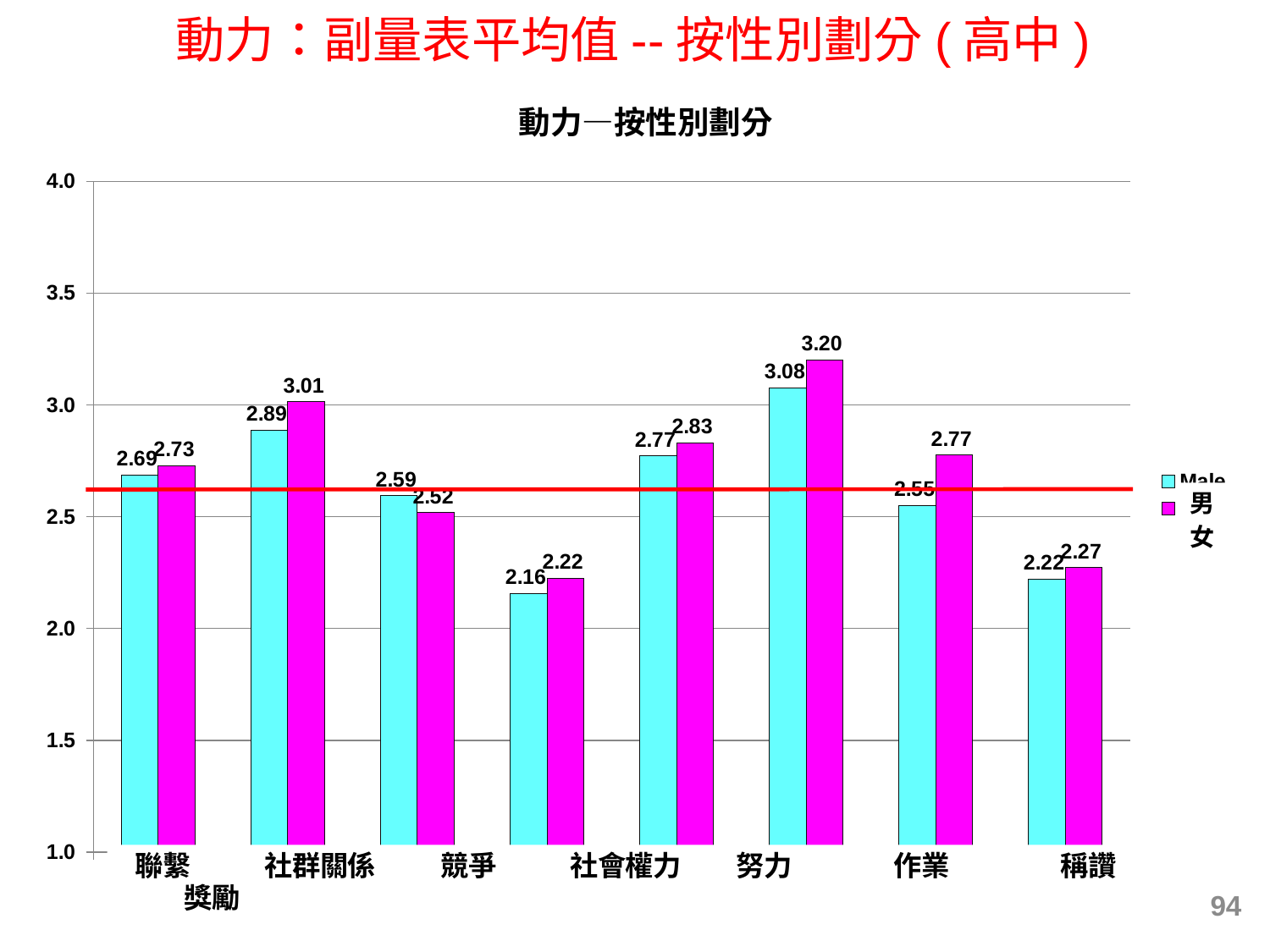
What is the value for 男 (male) in the 競爭 category? 2.59 In the 競爭 category, which is larger, the 男 (male) value or the 女 (female) value? 男 (male) What colour are the bars for the 女 (female) series? magenta How many categories are shown on the x axis of the chart? 8 What type of chart is shown on the slide? bar chart What is the difference between the 女 (female) and 男 (male) values in the 社群關係 category? 0.12